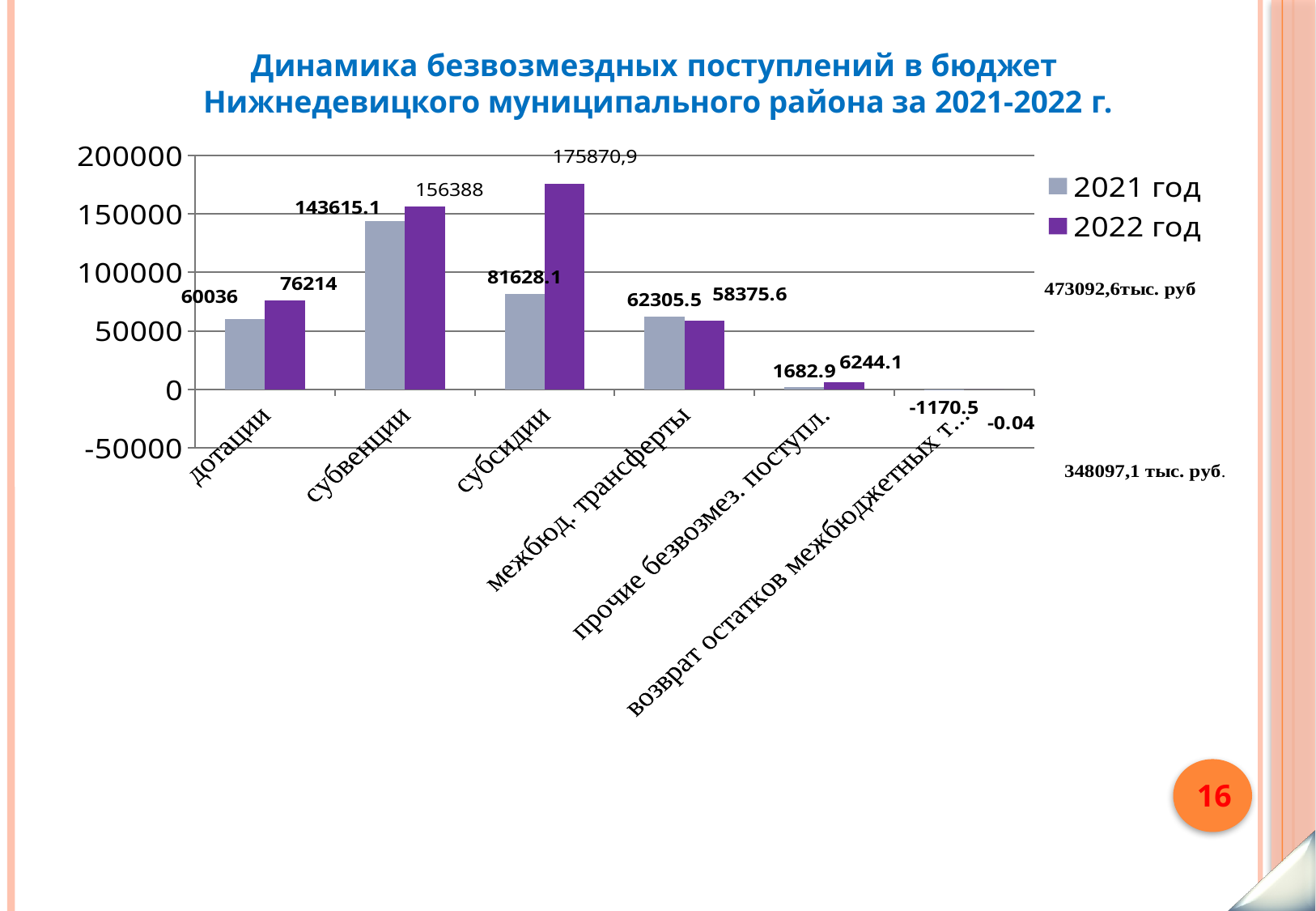
Which category has the highest value in the 2022 год series? субсидии How many categories are shown on the x axis of the chart? 6 What is the value for межбюд. трансферты in the 2022 год series? 58375.6 What is the difference between the 2022 год and 2021 год values for дотации? 16178 For субвенции, which series has the larger value, 2021 год or 2022 год? 2022 год What kind of chart is shown on the slide? bar chart What is the value for прочие безвозмез. поступл. in the 2021 год series? 1682.9 What is the difference between the 2021 год and 2022 год values for межбюд. трансферты? 3929.9 How many series does the legend list? 2 Which category has the highest value in the 2021 год series? субвенции What is the value for субсидии in the 2022 год series? 175870,9 What is the value for дотации in the 2021 год series? 60036